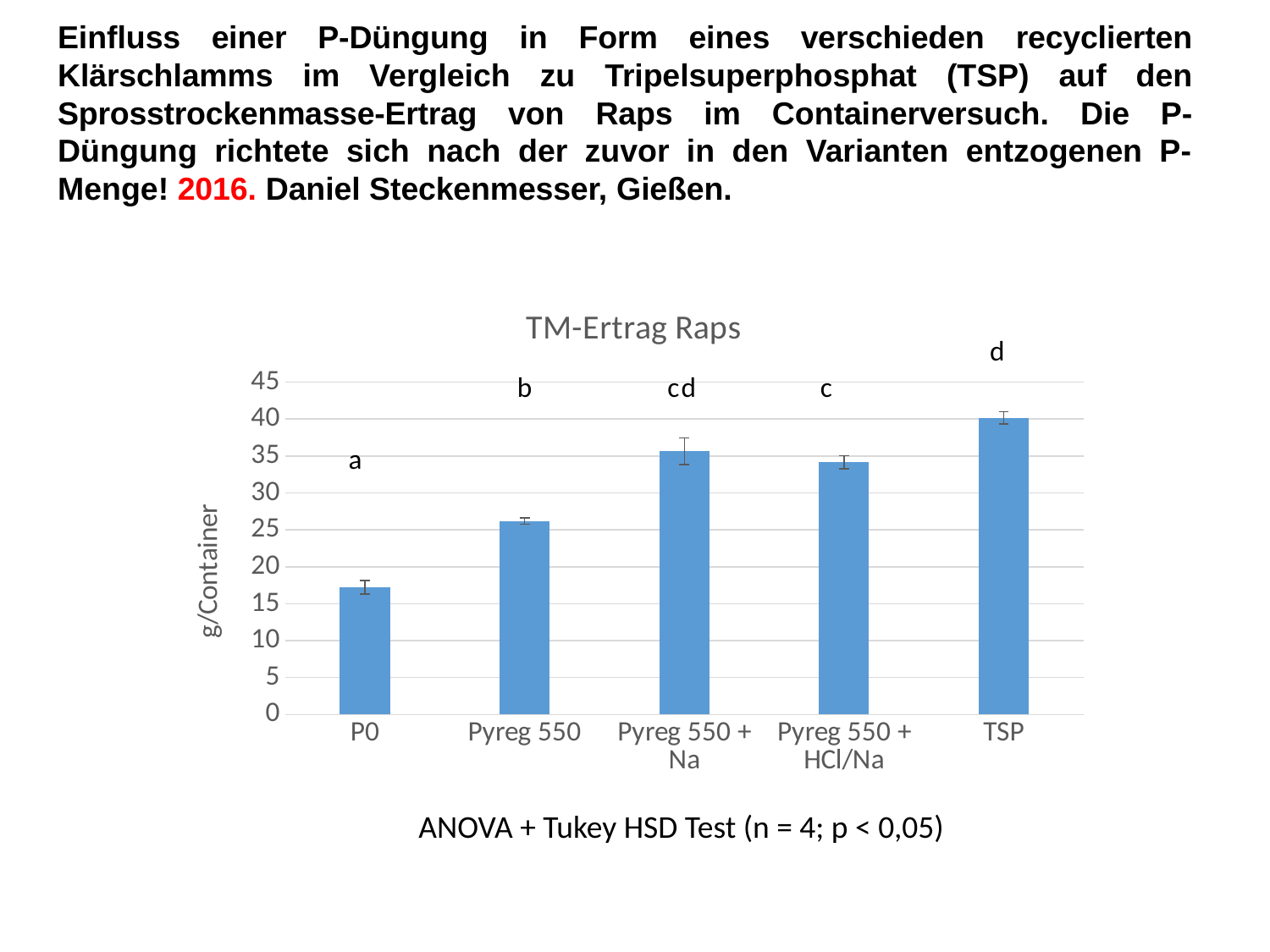
Is the value for Pyreg 550 greater or less than 25? greater How many categories are shown on the x axis of the chart? 5 Which is larger, the value for Pyreg 550 or the value for P0? Pyreg 550 What is the label of the y axis of the chart? g/Container Which category has the highest TM-Ertrag value? TSP Is the value for TSP greater or less than 35? greater What is the title of the chart? TM-Ertrag Raps What kind of chart is shown on the slide? bar chart Which is larger, the value for TSP or the value for Pyreg 550 + Na? TSP Is the value for Pyreg 550 + HCl/Na greater or less than 30? greater Which category has the lowest TM-Ertrag value? P0